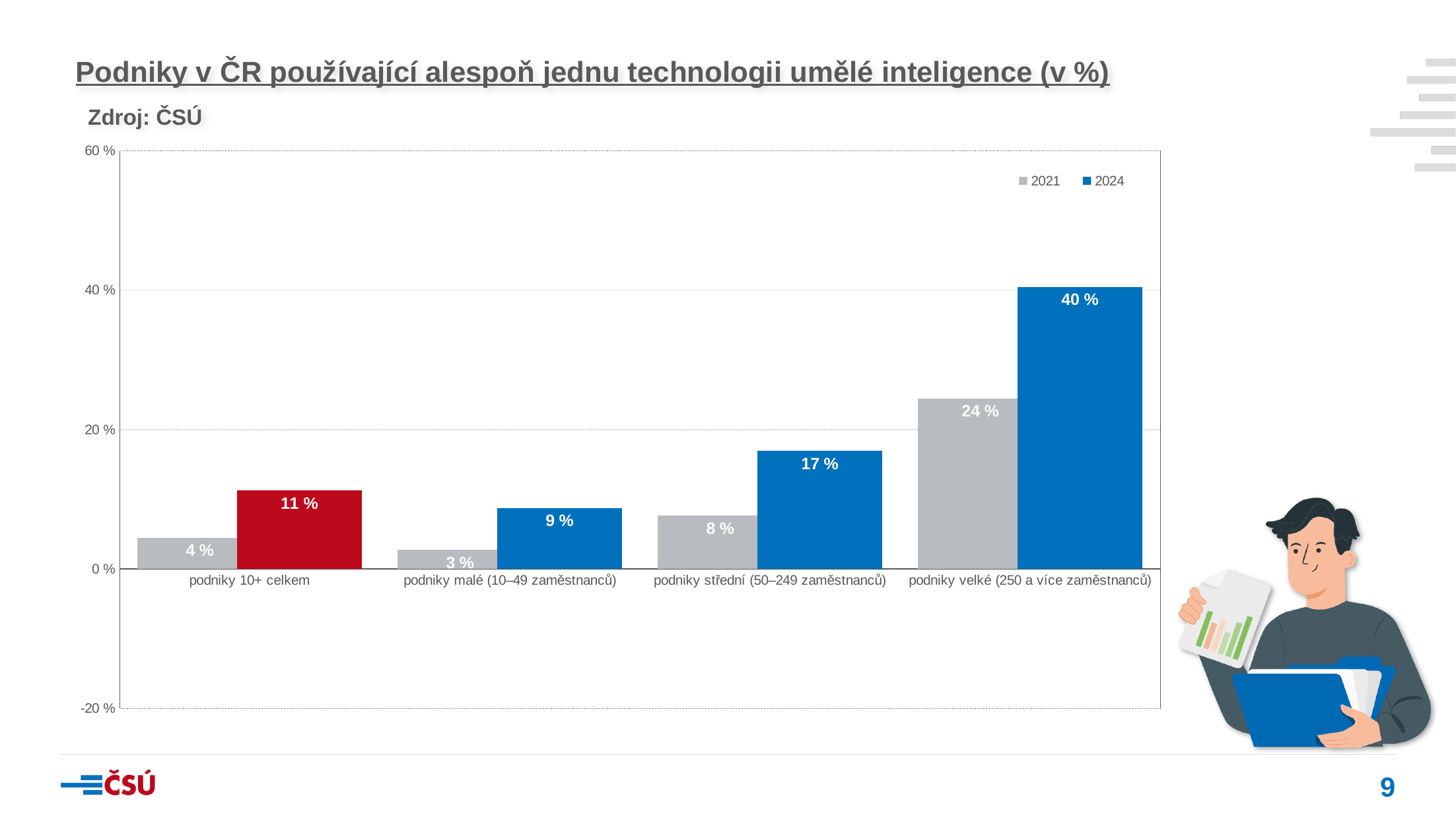
What is the 2024 value for podniky 10+ celkem? 11 % How many categories are shown on the x axis? 4 What is the 2021 value for podniky malé (10–49 zaměstnanců)? 3 % Which category has the lowest 2021 value? podniky malé (10–49 zaměstnanců) What is the 2024 value for podniky velké (250 a více zaměstnanců)? 40 % What source is cited for the chart? ČSÚ Which is larger: the 2021 value for podniky velké (250 a více zaměstnanců) or the 2024 value for podniky střední (50–249 zaměstnanců)? 2021 value for podniky velké (250 a více zaměstnanců) What is the difference between the 2024 and 2021 values for podniky střední (50–249 zaměstnanců)? 9 % What is the difference between the 2024 values for podniky velké (250 a více zaměstnanců) and podniky 10+ celkem? 29 % What kind of chart is shown on the slide? bar chart How many series does the legend list? 2 Which category has the highest 2024 value? podniky velké (250 a více zaměstnanců)